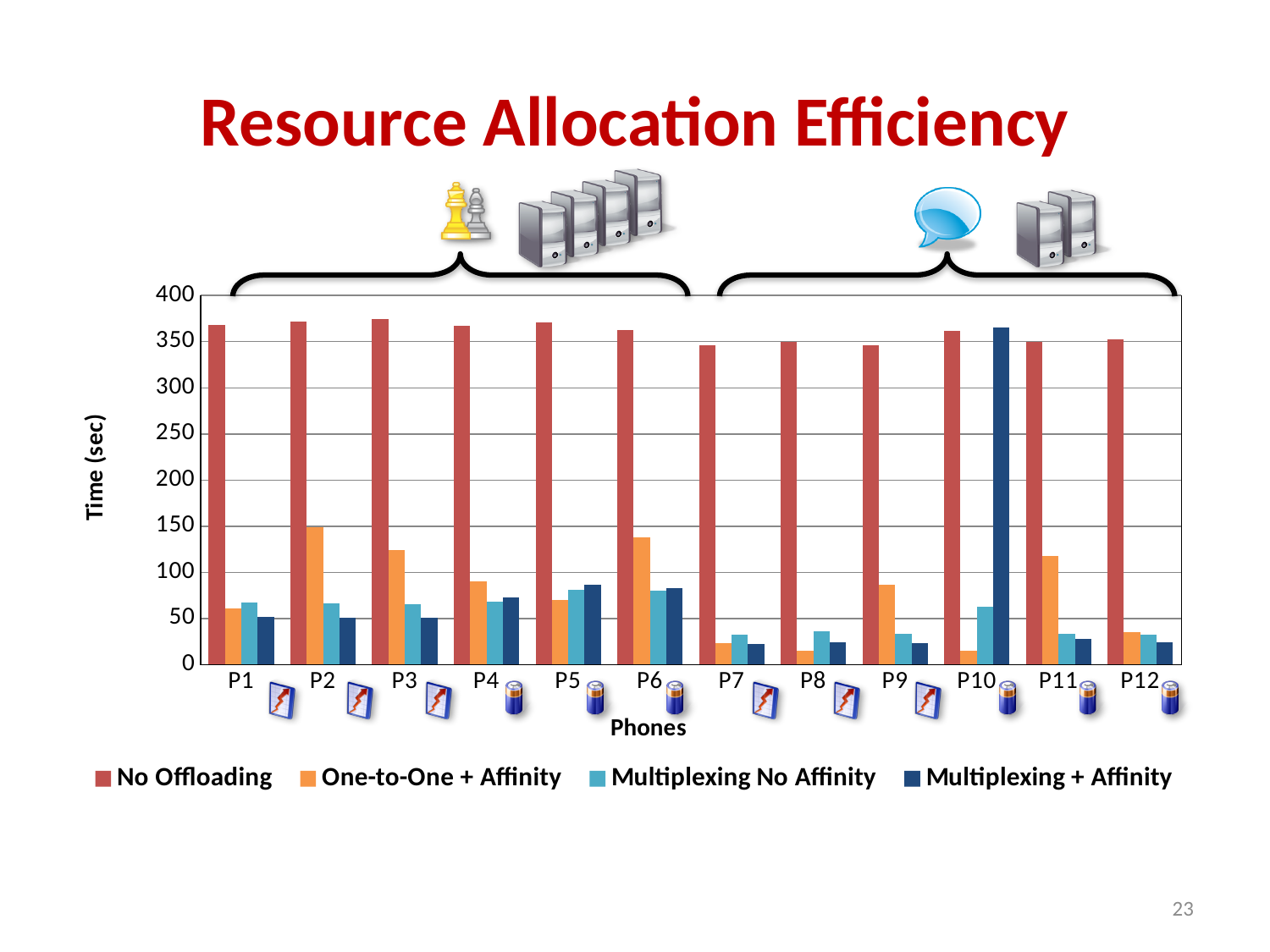
For P2, which is larger: One-to-One + Affinity or Multiplexing No Affinity? One-to-One + Affinity Is the No Offloading value for P1 greater or less than 350? greater What kind of chart is shown on the slide? bar chart Is the Multiplexing + Affinity value for P10 greater or less than 300? greater How many phones (categories) are shown on the x axis? 12 Which phone has the highest Multiplexing + Affinity value? P10 For P9, which is larger: One-to-One + Affinity or Multiplexing No Affinity? One-to-One + Affinity Is the One-to-One + Affinity value for P2 greater or less than 100? greater How many series does the legend list? 4 What is the title of the y axis? Time (sec)